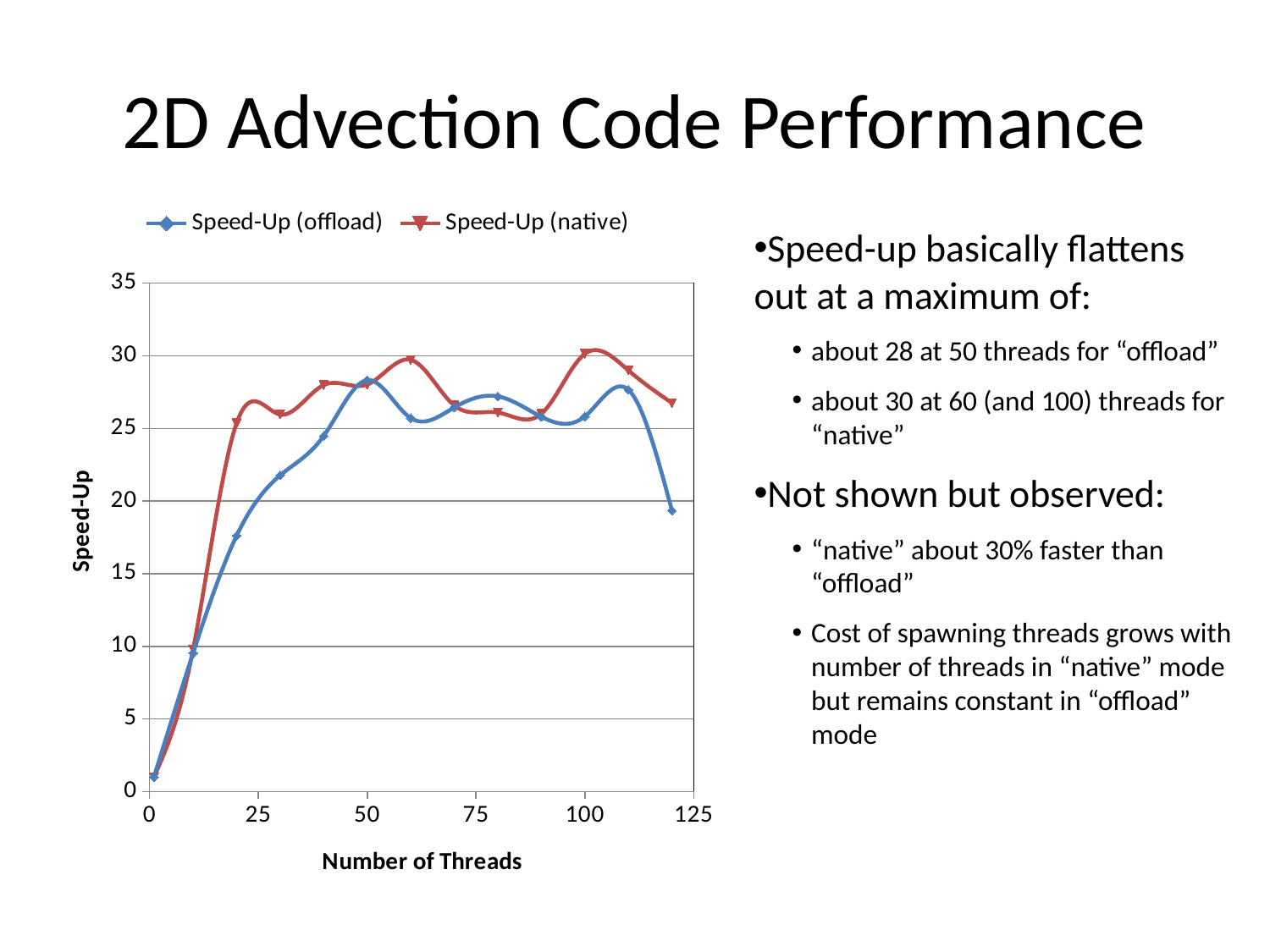
What is the label of the x axis of the chart? Number of Threads What are the two series named in the chart legend? Speed-Up (offload) and Speed-Up (native) What kind of chart is shown on the slide? line chart At 20 threads, which series has the higher speed-up, Speed-Up (offload) or Speed-Up (native)? Speed-Up (native) Does the Speed-Up (offload) series rise or fall between 0 and 50 threads? rise Is the Speed-Up (native) value at 60 threads greater or less than 25? greater How many series does the chart legend list? 2 Is the Speed-Up (offload) value at 20 threads greater or less than 15? greater Is the Speed-Up (native) value at 100 threads greater or less than 25? greater At 120 threads, which series has the higher speed-up, Speed-Up (offload) or Speed-Up (native)? Speed-Up (native) Which series reaches the highest speed-up value anywhere on the chart? Speed-Up (native)